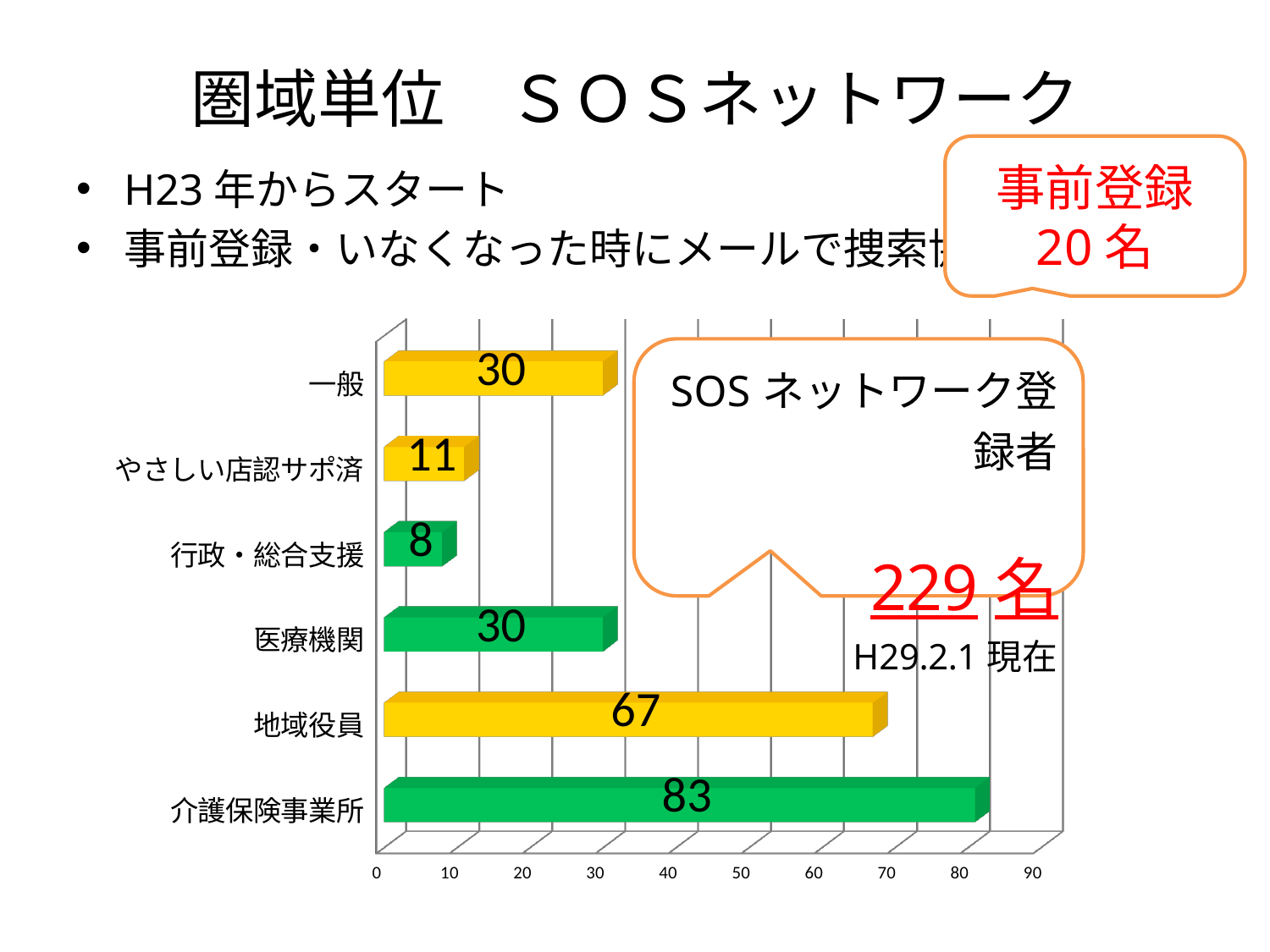
What is the difference between the values for 介護保険事業所 and 地域役員? 16 Is the value for 地域役員 greater or less than 60? greater What is the total number of SOS network registrants stated in the callout on the chart? 229名 What is the value for 介護保険事業所? 83 What is the value for 行政・総合支援? 8 What kind of chart is shown on the slide? bar chart What is the value for やさしい店認サポ済? 11 Which is larger, the value for 医療機関 or the value for やさしい店認サポ済? 医療機関 Which category has the highest value? 介護保険事業所 How many categories are shown in the chart? 6 Which category has the lowest value? 行政・総合支援 What is the value for 地域役員? 67